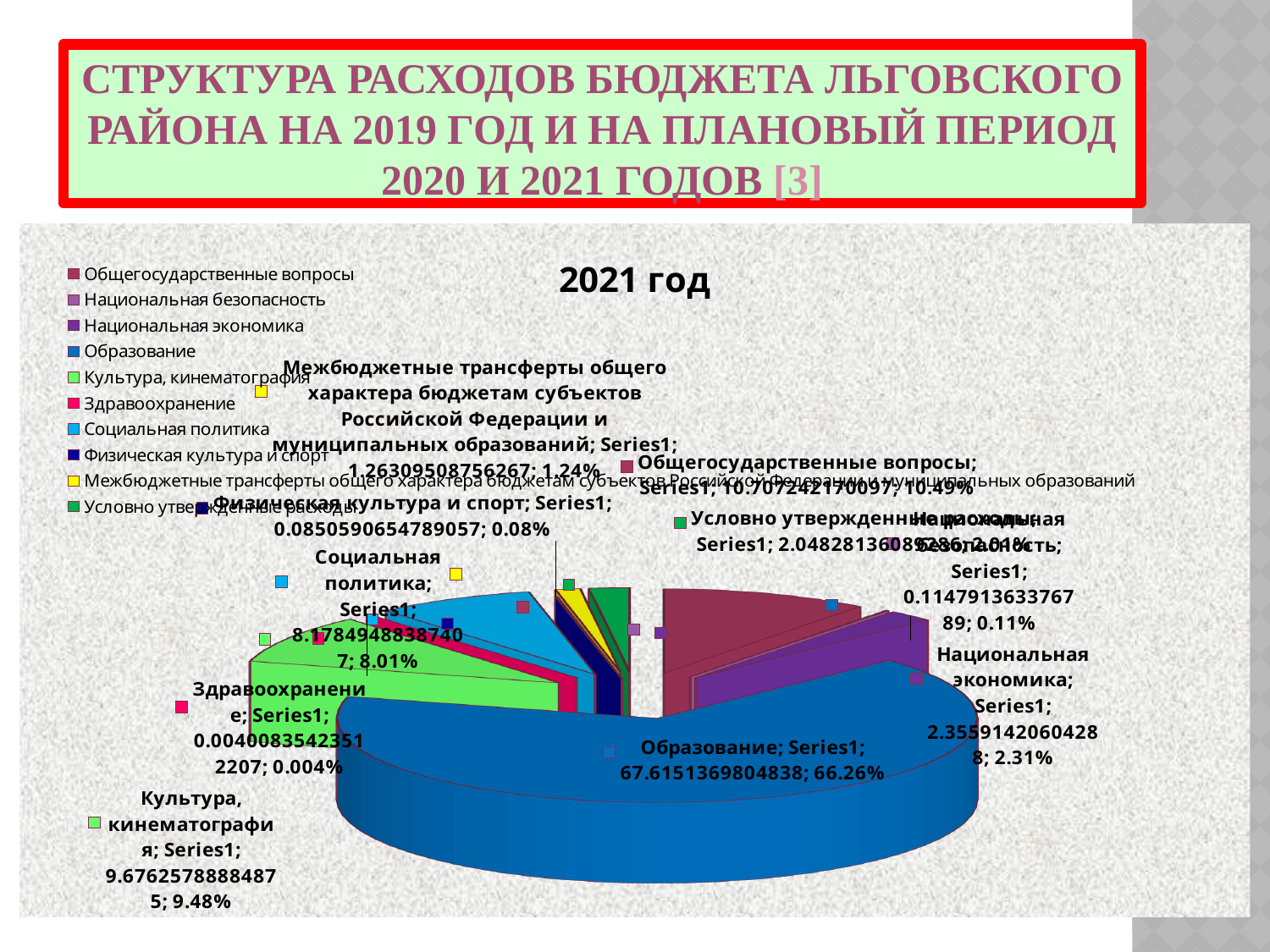
What is the difference in percentage points between the shares of Образование and Общегосударственные вопросы? 55.77 What percentage share does Национальная экономика have? 2.31% What percentage share does Общегосударственные вопросы have? 10.49% What percentage share does Социальная политика have? 8.01% Which has a larger share: Культура, кинематография or Социальная политика? Культура, кинематография Which category has the largest share of the pie? Образование How many categories does the chart's legend list? 10 Which category has the smallest share of the pie? Здравоохранение What is the title of the chart? 2021 год What kind of chart is shown on the slide? pie chart